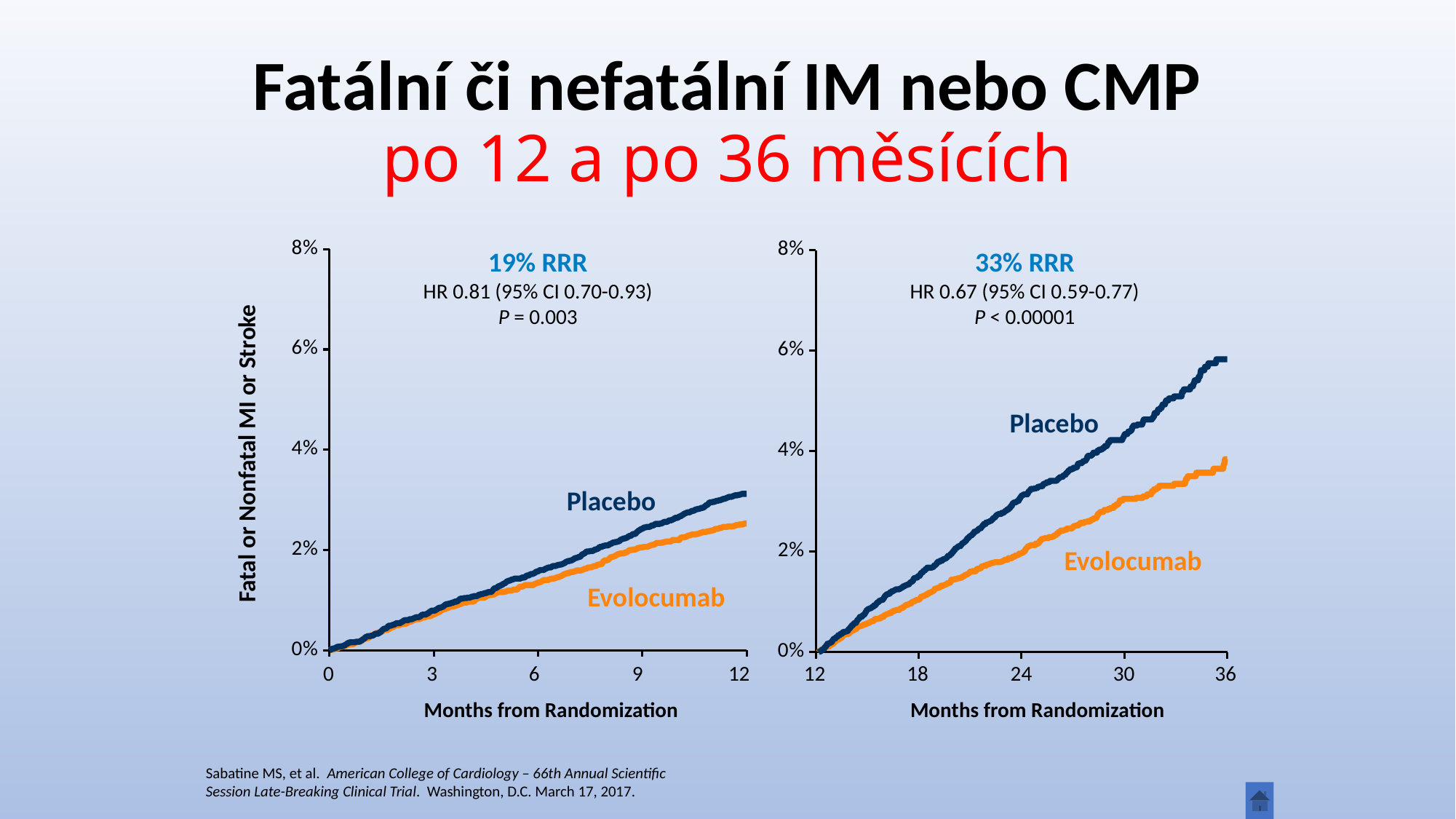
On the left chart (0 to 12 months), do the Evolocumab values rise or fall along the x axis? Rise How many series are plotted on the right chart (12 to 36 months)? 2 On the left chart (0 to 12 months), which series is higher at 12 months, Placebo or Evolocumab? Placebo On the right chart (12 to 36 months), is the value for Evolocumab at 36 months greater or less than 4%? less What relative risk reduction (RRR) is shown above the left chart (0 to 12 months)? 19% RRR On the right chart (12 to 36 months), do the Placebo values rise or fall as months increase? Rise What hazard ratio is shown above the right chart (12 to 36 months)? HR 0.67 (95% CI 0.59-0.77) On the left chart (0 to 12 months), is the value for Placebo at 12 months greater or less than 2%? greater On the right chart (12 to 36 months), which series is higher at 36 months, Placebo or Evolocumab? Placebo On the right chart (12 to 36 months), is the value for Placebo at 36 months greater or less than 4%? greater What kind of chart is the left chart (0 to 12 months)? Line chart